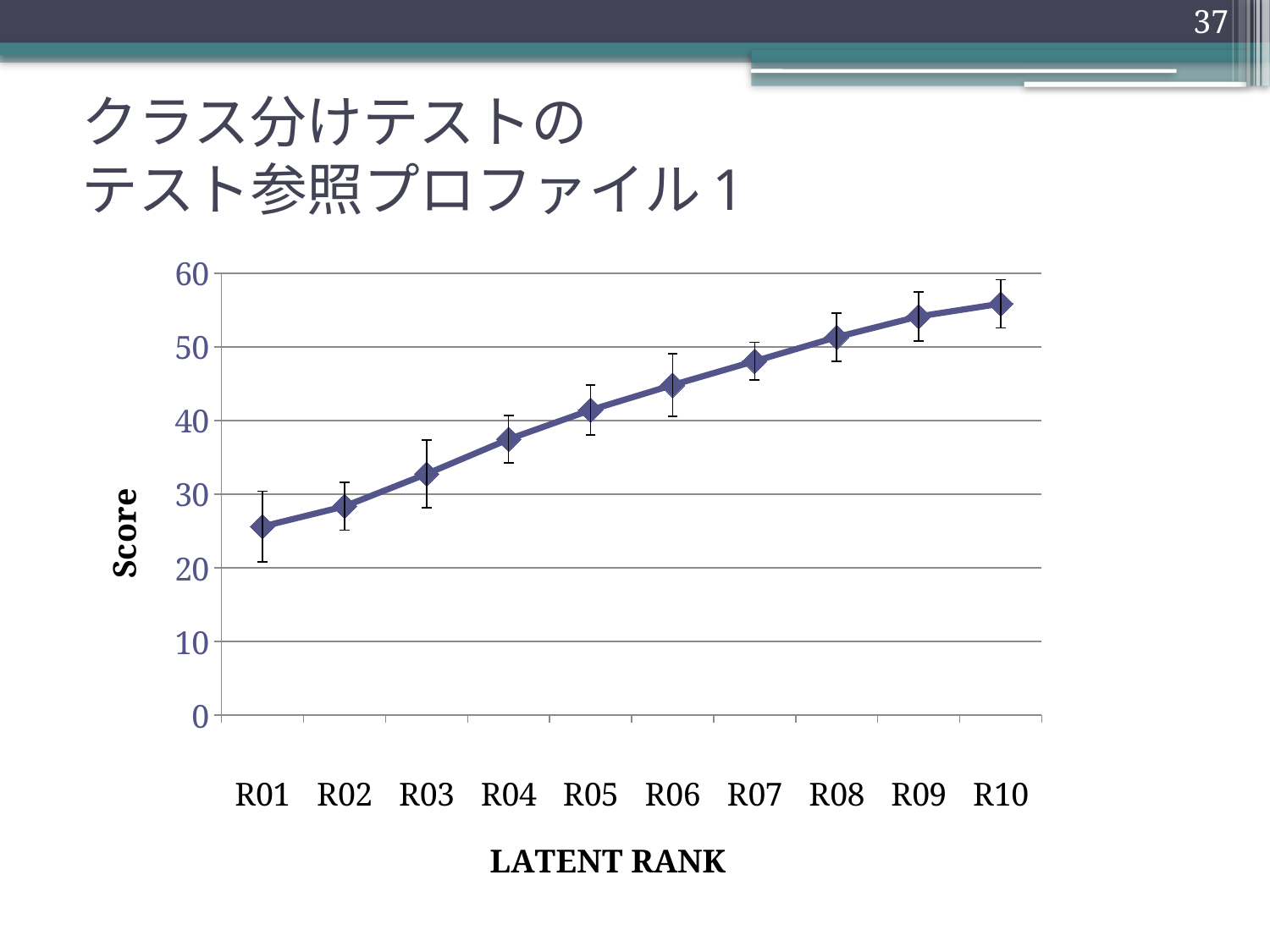
What is the title of the y axis? Score Is the score for R03 greater or less than 40? less Which latent rank has the lowest score? R01 Which has the higher score, R04 or R08? R08 What kind of chart is shown on the slide? line chart Is the score for R01 greater or less than 30? less Is the score for R10 greater or less than 50? greater Which latent rank has the highest score? R10 Do the scores rise or fall as the latent rank goes from R01 to R10? rise How many latent rank categories are plotted on the x axis? 10 What is the title of the x axis? LATENT RANK